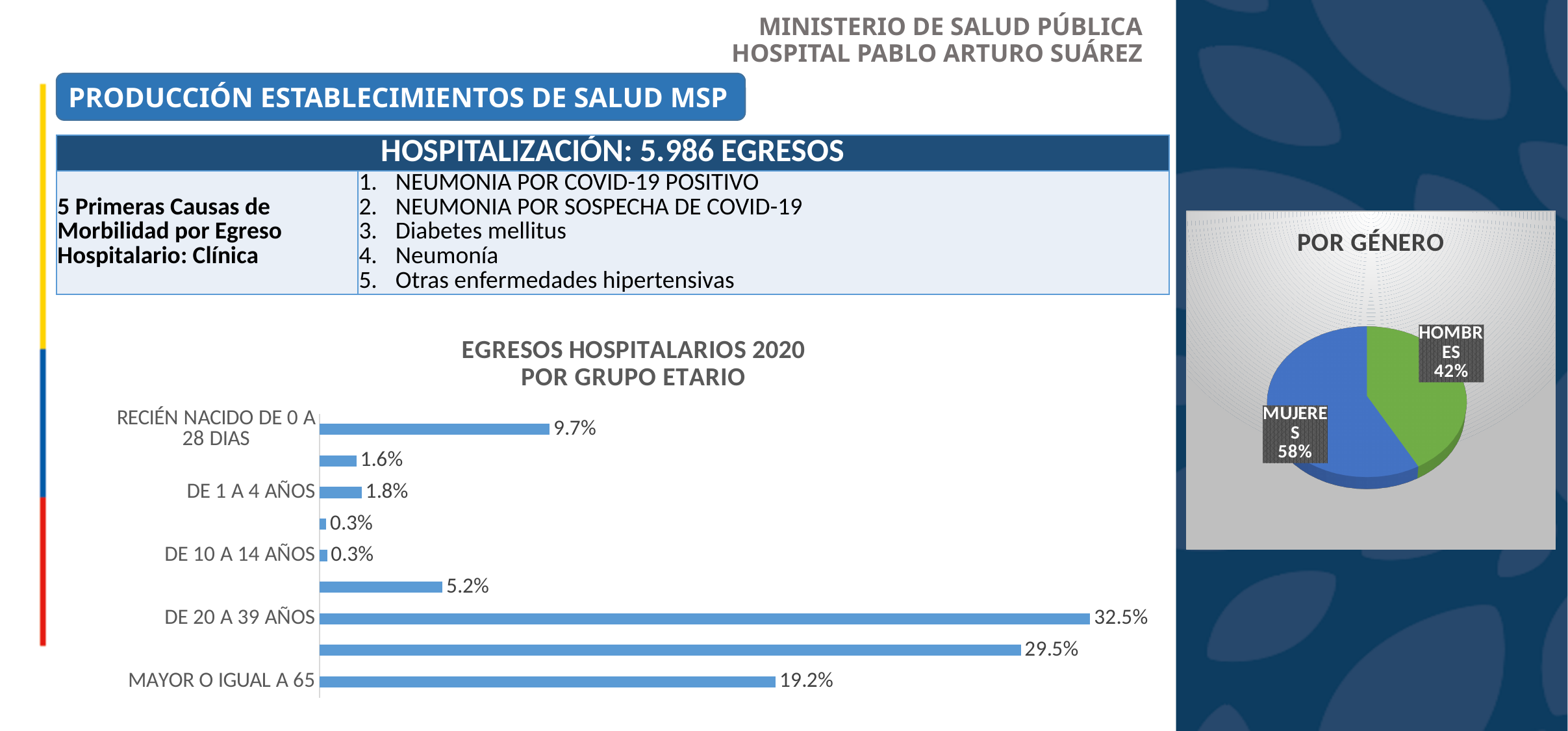
In the pie chart 'POR GÉNERO', what share is MUJERES? 58% In the chart 'EGRESOS HOSPITALARIOS 2020 POR GRUPO ETARIO', what is the value for DE 1 A 4 AÑOS? 1.8% In the chart 'EGRESOS HOSPITALARIOS 2020 POR GRUPO ETARIO', what is the value for RECIÉN NACIDO DE 0 A 28 DIAS? 9.7% In the chart 'EGRESOS HOSPITALARIOS 2020 POR GRUPO ETARIO', which is larger, RECIÉN NACIDO DE 0 A 28 DIAS or DE 1 A 4 AÑOS? RECIÉN NACIDO DE 0 A 28 DIAS In the chart 'EGRESOS HOSPITALARIOS 2020 POR GRUPO ETARIO', what is the value for DE 20 A 39 AÑOS? 32.5% In the chart 'EGRESOS HOSPITALARIOS 2020 POR GRUPO ETARIO', what is the value for DE 10 A 14 AÑOS? 0.3% How many bars are plotted in the chart 'EGRESOS HOSPITALARIOS 2020 POR GRUPO ETARIO'? 9 What kind of chart is 'EGRESOS HOSPITALARIOS 2020 POR GRUPO ETARIO'? Bar chart In the chart 'EGRESOS HOSPITALARIOS 2020 POR GRUPO ETARIO', which age group has the highest value? DE 20 A 39 AÑOS In the chart 'EGRESOS HOSPITALARIOS 2020 POR GRUPO ETARIO', what is the value for MAYOR O IGUAL A 65? 19.2% In the pie chart 'POR GÉNERO', what is the difference between MUJERES and HOMBRES? 16% In the chart 'EGRESOS HOSPITALARIOS 2020 POR GRUPO ETARIO', what is the difference between DE 20 A 39 AÑOS and MAYOR O IGUAL A 65? 13.3%